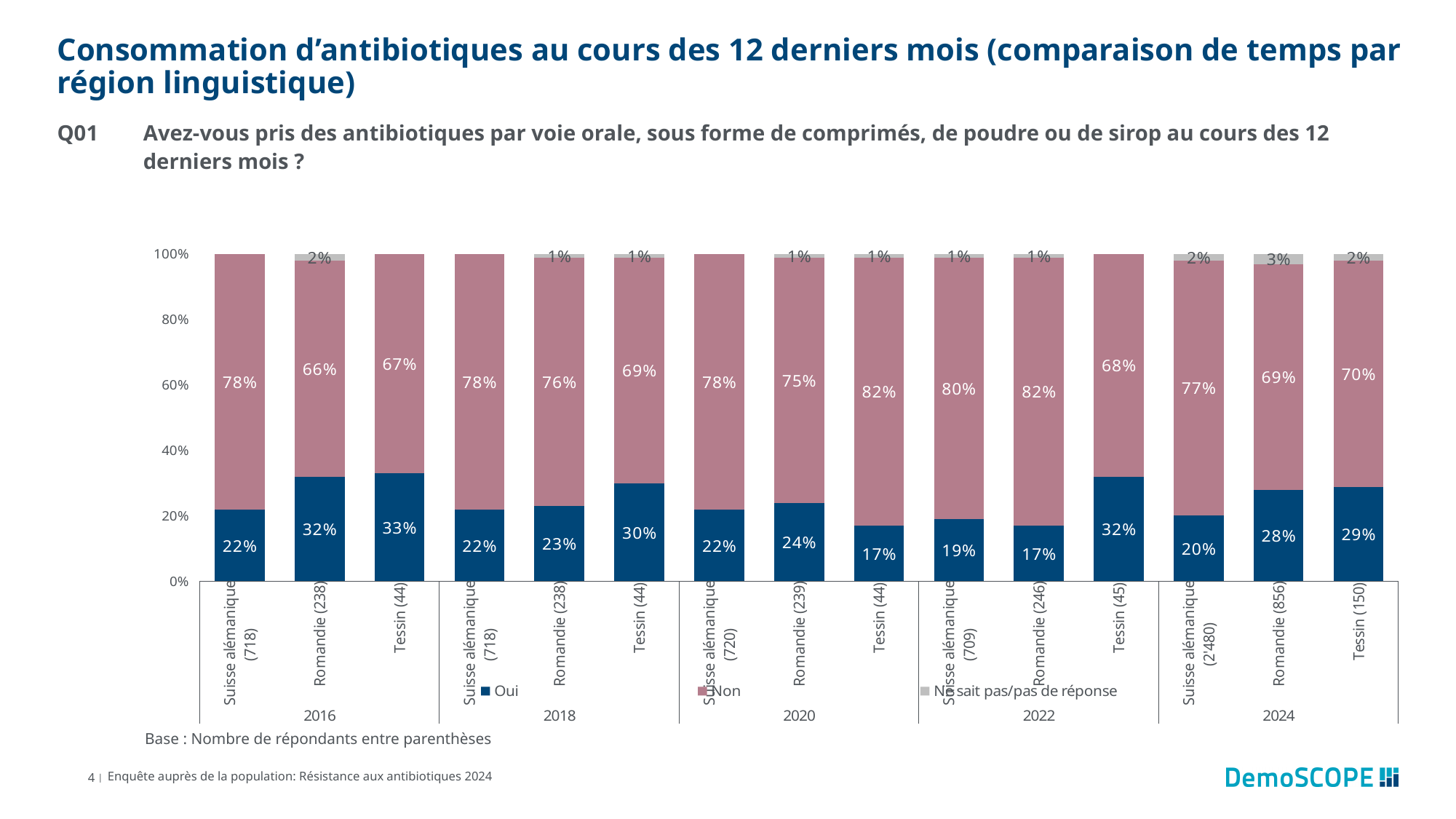
How many bars are shown in the chart? 15 Is the 'Non' share for Tessin in 2018 greater or less than 60%? greater What is the 'Ne sait pas/pas de réponse' value for Romandie in 2024? 3% How many series does the legend list? 3 What is the total of the stacked bar for Romandie in 2016 (Oui + Non + Ne sait pas)? 100% Which has a larger 'Oui' share in 2024: Romandie or Suisse alémanique? Romandie Which bar has the highest 'Oui' share across all years and regions? Tessin (44) in 2016 What is the difference between the 'Oui' share for Tessin in 2022 and for Romandie in 2022? 15 percentage points What kind of chart is shown on the slide? Stacked bar chart What is the 'Non' value for Tessin in 2020? 82% Which bar has the lowest 'Non' share across all years and regions? Romandie (238) in 2016 What percentage of respondents in Romandie answered 'Oui' in 2016? 32%